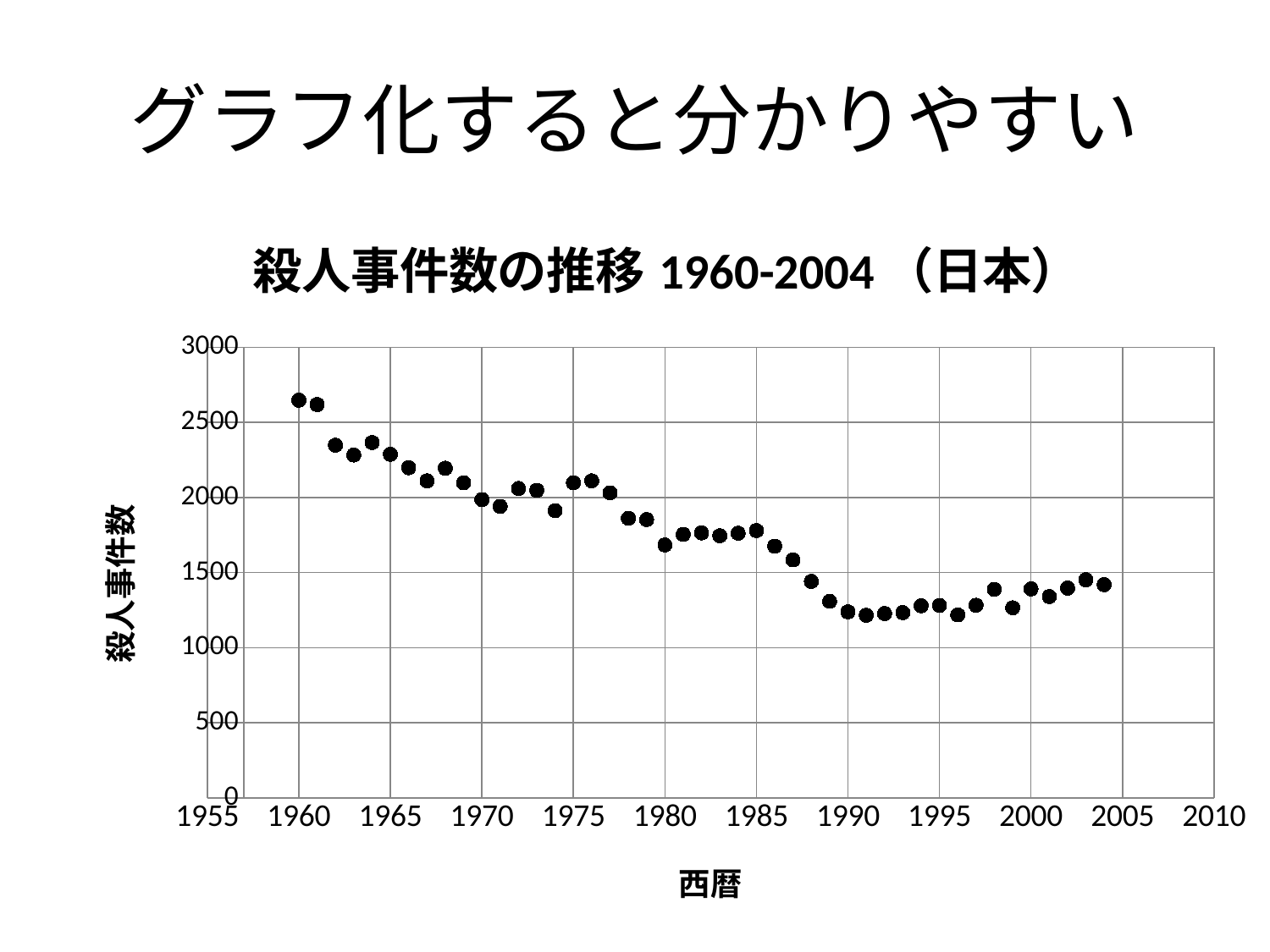
Is the value for 1980 greater or less than 2000? less What kind of chart is shown on the slide? scatter chart Which year has the larger value, 1960 or 1990? 1960 Which year has the larger value, 1965 or 2000? 1965 Is the value for 1965 greater or less than 2000? greater Overall, do the values rise or fall from 1960 to 2004? fall How many years of data are plotted, according to the chart title's range 1960-2004? 45 What is the title of the chart? 殺人事件数の推移 1960-2004 （日本） Is the value for 1985 greater or less than 2000? less What is the label of the vertical axis? 殺人事件数